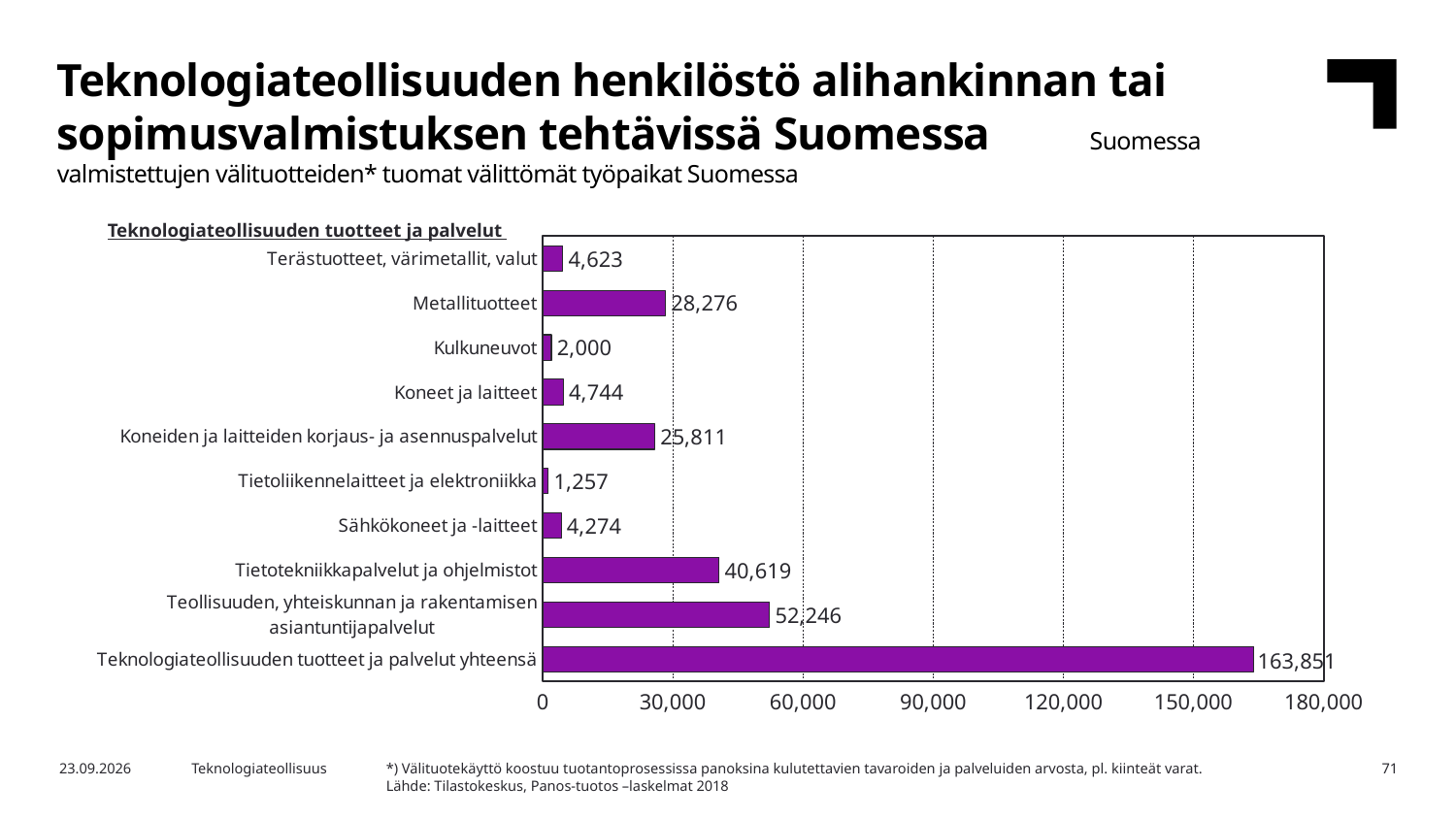
What is the value for Teknologiateollisuuden tuotteet ja palvelut yhteensä? 163,851 What kind of chart is shown on the slide? bar chart Excluding the total bar, which category has the highest value? Teollisuuden, yhteiskunnan ja rakentamisen asiantuntijapalvelut What is the maximum value shown on the x axis? 180,000 Is the value for Tietotekniikkapalvelut ja ohjelmistot greater or less than 30,000? greater What is the value for Metallituotteet? 28,276 What is the value for Kulkuneuvot? 2,000 How many categories are shown in the chart? 10 Which category has the lowest value? Tietoliikennelaitteet ja elektroniikka What is the difference between Teollisuuden, yhteiskunnan ja rakentamisen asiantuntijapalvelut and Tietotekniikkapalvelut ja ohjelmistot? 11,627 What is the value for Tietotekniikkapalvelut ja ohjelmistot? 40,619 Which is larger, Metallituotteet or Koneiden ja laitteiden korjaus- ja asennuspalvelut? Metallituotteet